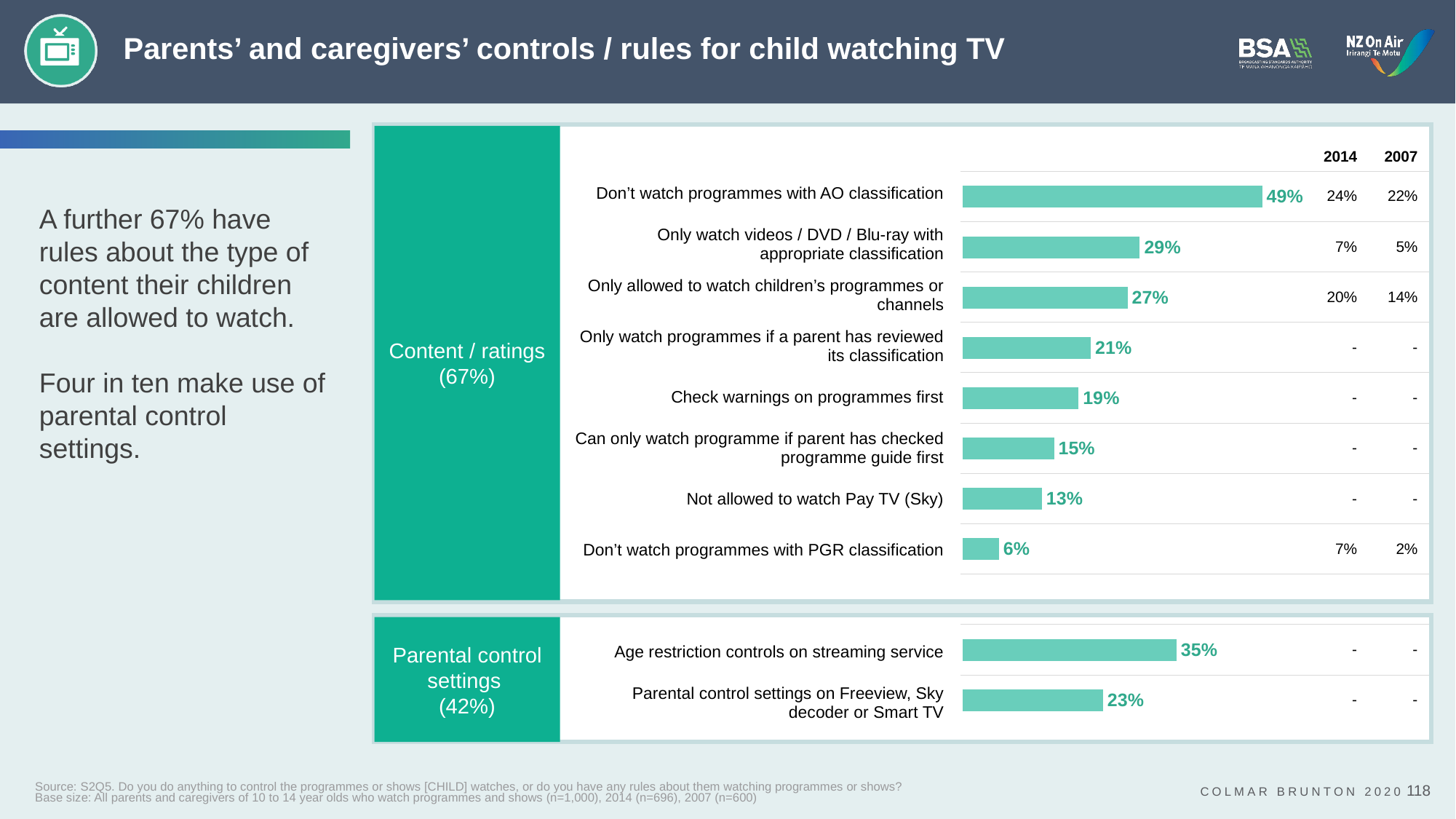
In the Content / ratings chart, what percentage of parents say their child doesn't watch programmes with AO classification? 49% In the Content / ratings chart, what was the 2014 value for 'Don't watch programmes with AO classification'? 24% In the Parental control settings chart, what is the difference between the two bars? 12% In the Parental control settings chart, what is the value for 'Age restriction controls on streaming service'? 35% How many bars are shown in the Parental control settings chart? 2 In the Content / ratings chart, what is the value for 'Check warnings on programmes first'? 19% How many bars are shown in the Content / ratings chart? 8 In the Content / ratings chart, which rule has the lowest percentage? Don't watch programmes with PGR classification In the Content / ratings chart, which is larger: 'Not allowed to watch Pay TV (Sky)' or 'Can only watch programme if parent has checked programme guide first'? Can only watch programme if parent has checked programme guide first In the Content / ratings chart, which rule has the highest percentage? Don't watch programmes with AO classification What type of chart is used on this slide? Bar chart In the Content / ratings chart, what is the difference between 'Only watch videos / DVD / Blu-ray with appropriate classification' and 'Only allowed to watch children's programmes or channels'? 2%